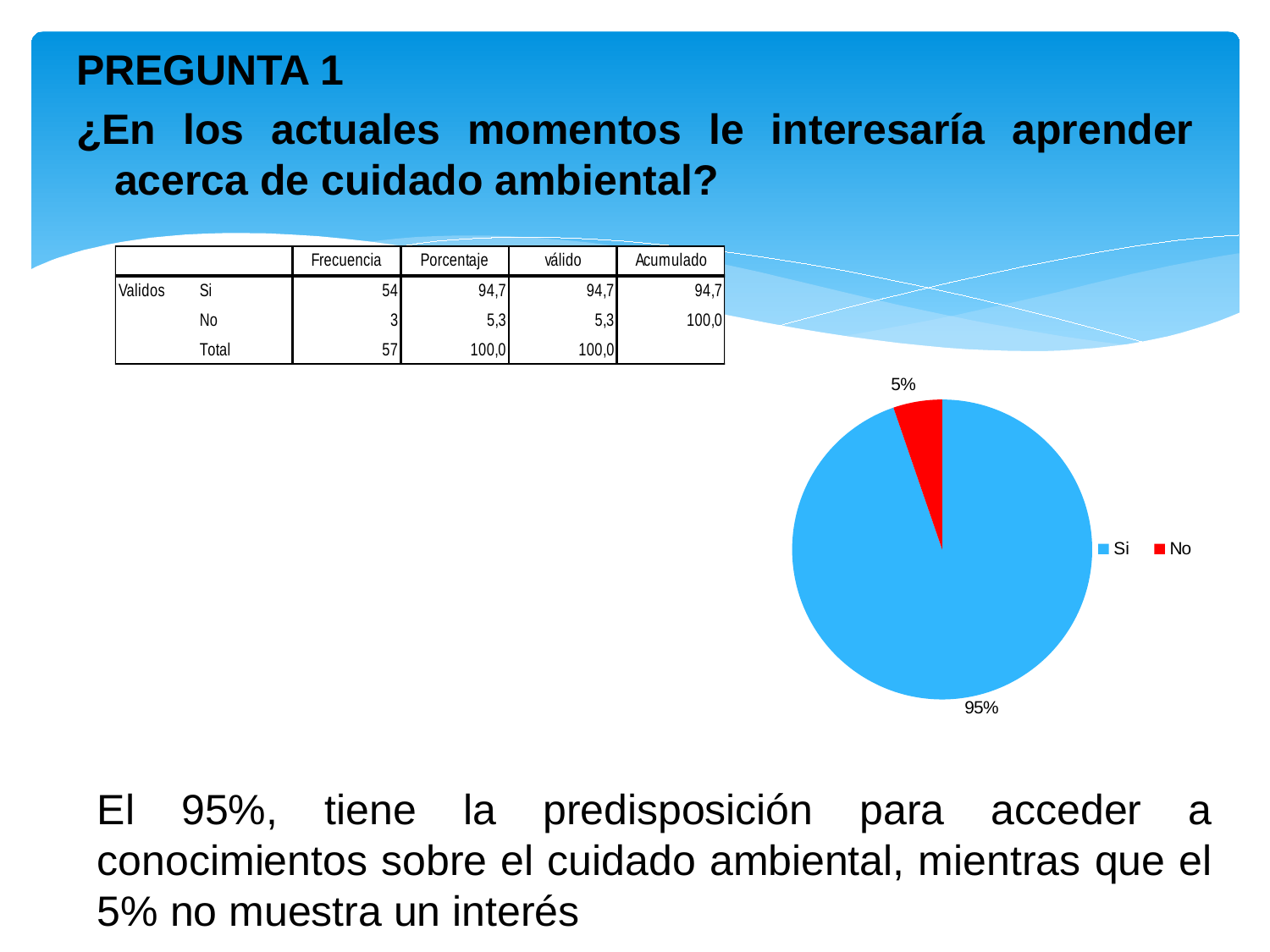
What kind of chart is shown on the slide? pie chart Which category has the smallest slice in the pie chart? No Which category has the largest slice in the pie chart? Si Which slice is larger, 'Si' or 'No'? Si How many slices does the pie chart have? 2 What percentage does the 'No' slice show in the pie chart? 5% What percentage does the 'Si' slice show in the pie chart? 95% How many entries does the legend of the pie chart list? 2 What colour is the 'No' slice in the pie chart? red What colour is the 'Si' slice in the pie chart? blue What is the difference in percentage points between the 'Si' and 'No' slices? 90